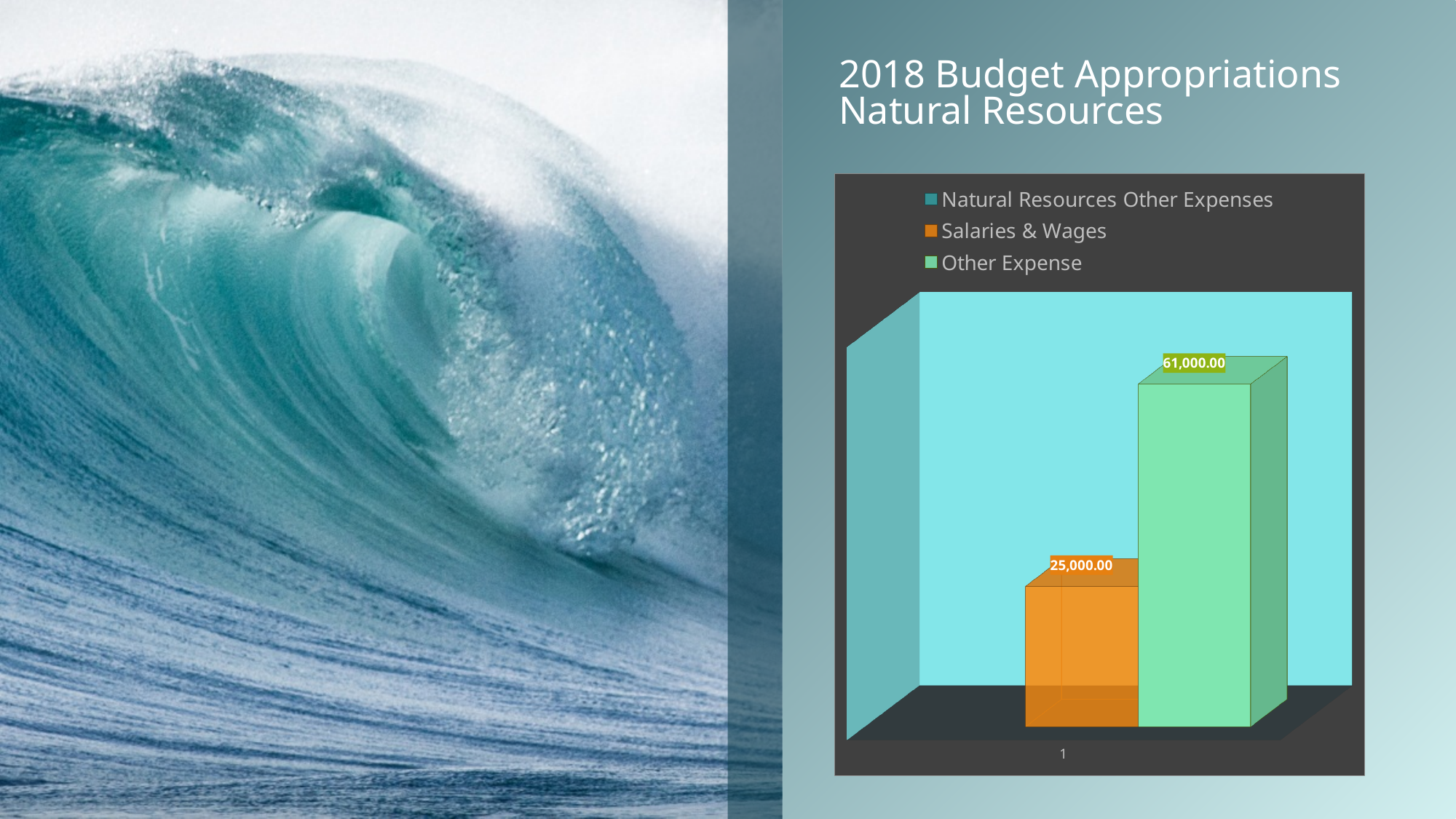
What is the value for Salaries & Wages? 25,000.00 What kind of chart is shown on the slide? Bar chart What is the label on the category axis? 1 How many series does the legend list? 3 What is the difference between the Other Expense value and the Salaries & Wages value? 36,000.00 What colour is the Salaries & Wages bar? Orange Which is larger, Salaries & Wages or Other Expense? Other Expense Which of the two plotted bars is lower, Salaries & Wages or Other Expense? Salaries & Wages What is the value for Other Expense? 61,000.00 What is the total of the Salaries & Wages and Other Expense values? 86,000.00 Which series has the highest value shown on the chart? Other Expense What is the title of the slide containing the chart? 2018 Budget Appropriations Natural Resources